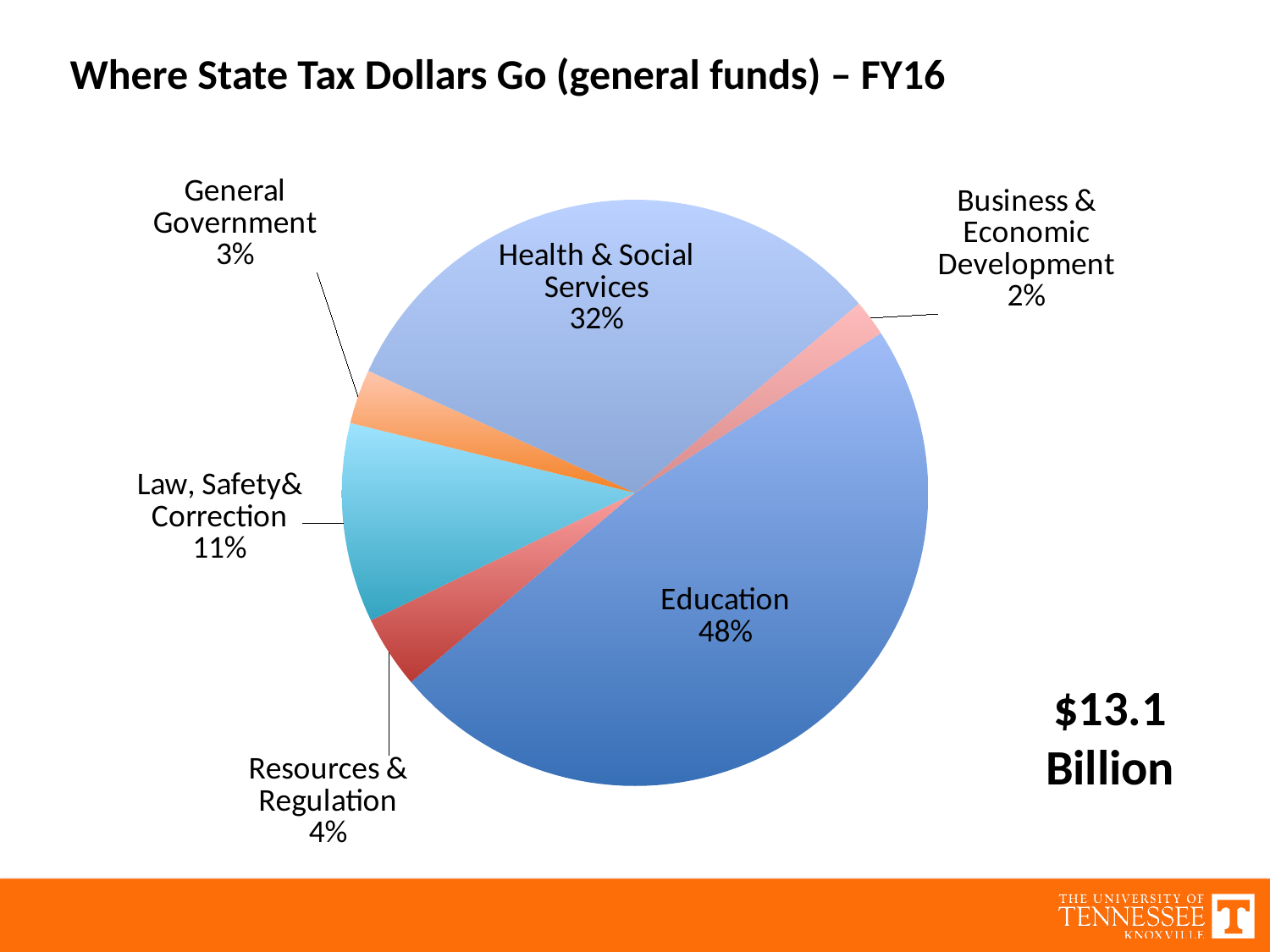
What share of state tax dollars goes to Law, Safety & Correction? 11% What share of state tax dollars goes to Education? 48% How many percentage points larger is the Education share than the Health & Social Services share? 16 Which category receives the largest share of state tax dollars? Education What share of state tax dollars goes to Business & Economic Development? 2% What is the title of the chart? Where State Tax Dollars Go (general funds) – FY16 What kind of chart is shown on the slide? Pie chart What share of state tax dollars goes to Health & Social Services? 32% Which receives a larger share, Law, Safety & Correction or Resources & Regulation? Law, Safety & Correction What total dollar amount is shown next to the pie chart? $13.1 Billion Which category receives the smallest share of state tax dollars? Business & Economic Development How many categories are shown in the pie chart? 6